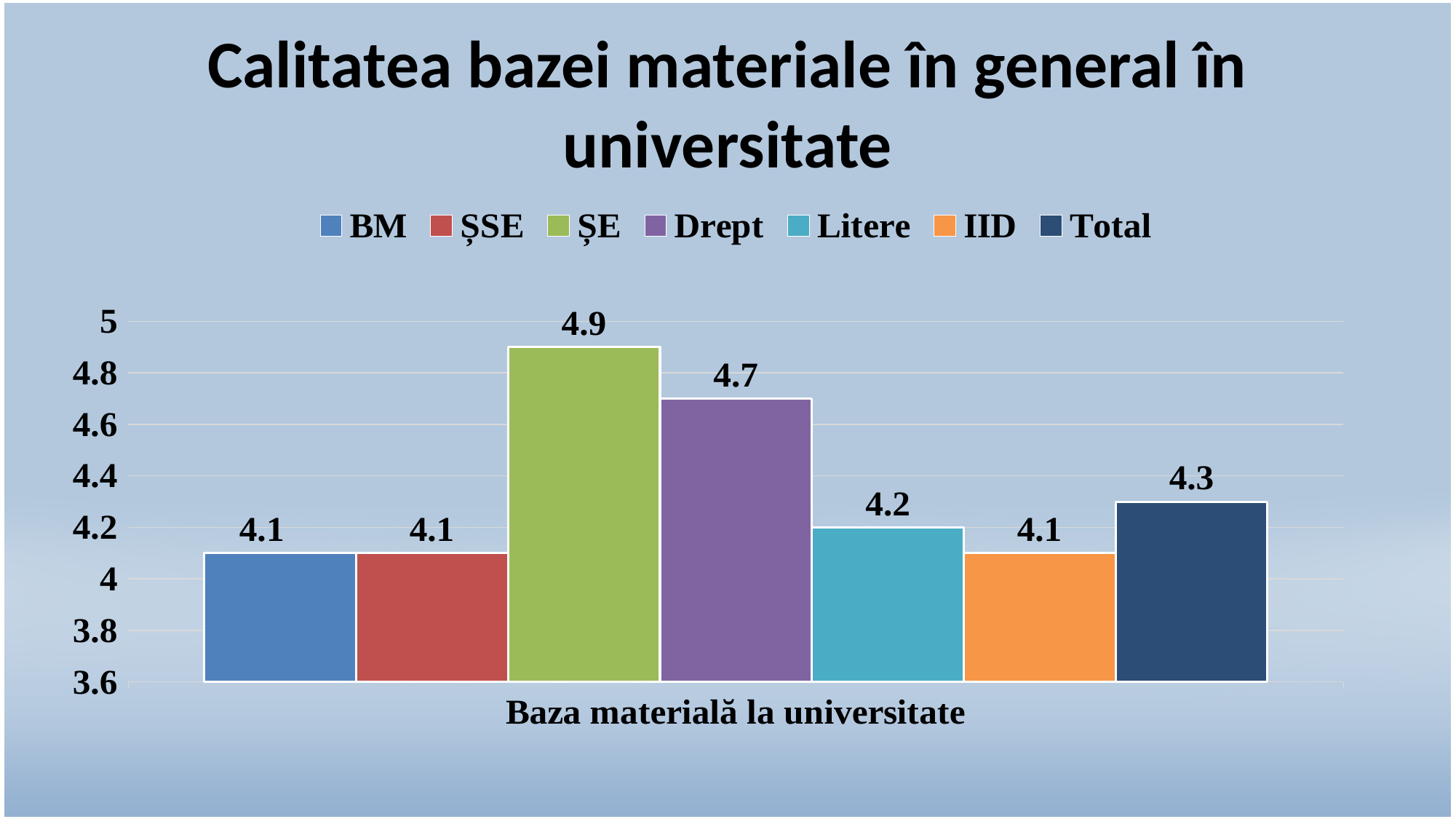
Which is larger, the value for Drept or the value for Litere? Drept What is the difference between the values for ȘE and Drept? 0.2 Is the value for ȘE greater or less than 4.8? greater What is the title of the chart? Calitatea bazei materiale în general în universitate What is the difference between the values for Total and BM? 0.2 How many series does the legend list? 7 What kind of chart is shown on the slide? bar chart Which series has the highest value? ȘE What is the value for Total? 4.3 What is the value for Drept? 4.7 What is the value for ȘE? 4.9 What is the value for Litere? 4.2